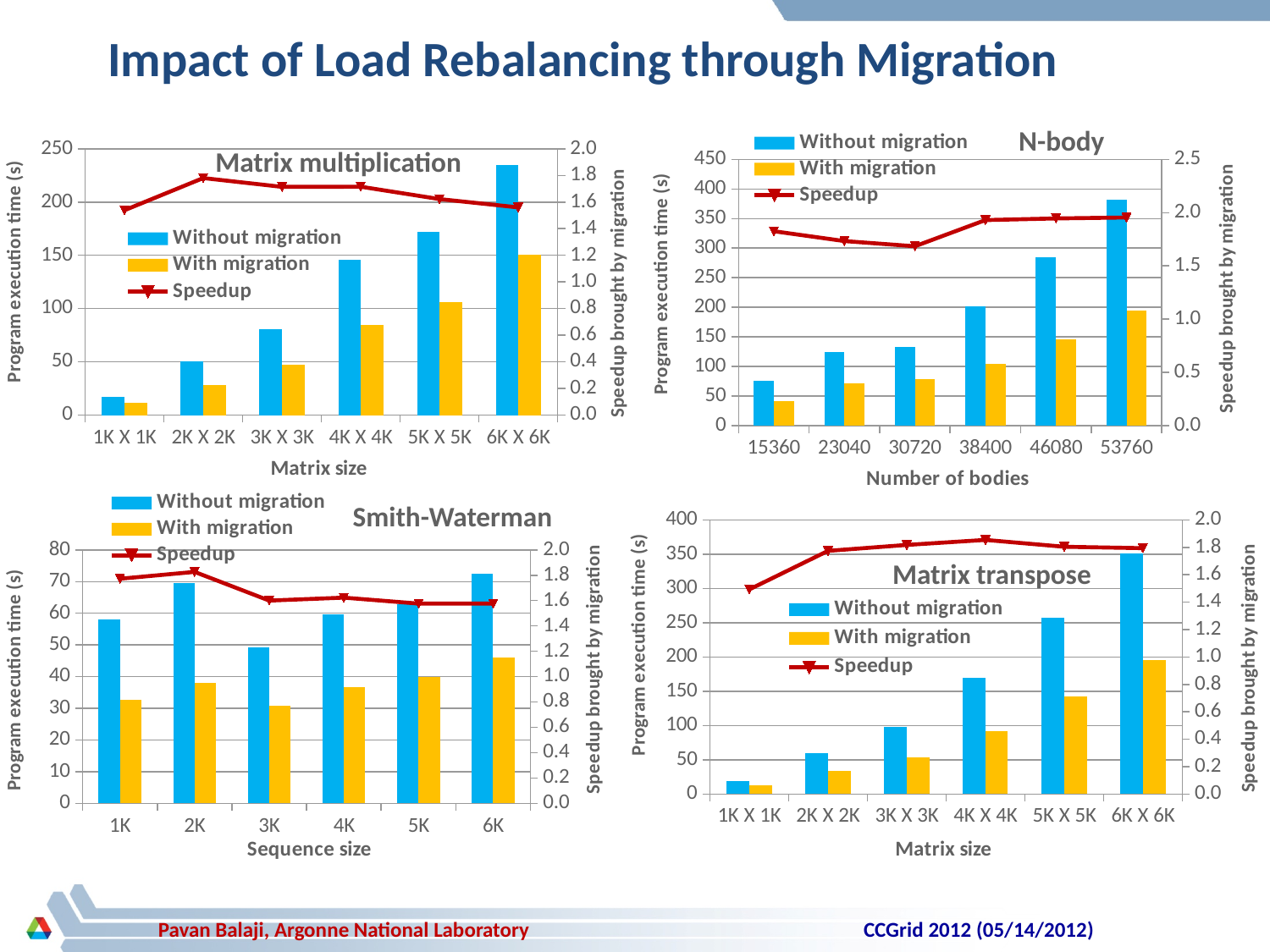
What is the label of the secondary (right-hand) y axis on the Matrix transpose chart? Speedup brought by migration In the Matrix multiplication chart, which matrix size has the highest 'Without migration' execution time? 6K X 6K In the N-body chart, which is larger: 'Without migration' at 23040 bodies or 'With migration' at 46080 bodies? With migration at 46080 In the Matrix multiplication chart, is the 'Without migration' value for 6K X 6K greater or less than 200? greater In the N-body chart, is the 'Without migration' value for 53760 bodies greater or less than 350? greater In the Matrix multiplication chart, does the 'Without migration' execution time rise or fall as matrix size increases? rise In the N-body chart, which number of bodies has the lowest 'Without migration' execution time? 15360 In the Matrix transpose chart, which matrix size has the lowest Speedup? 1K X 1K In the Matrix multiplication chart, how many series does the legend list? 3 In the Matrix multiplication chart, how many matrix sizes are shown on the x axis? 6 In the Smith-Waterman chart, is the 'With migration' value for 3K greater or less than 40? less In the Smith-Waterman chart, which sequence size has the lowest 'Without migration' execution time? 3K